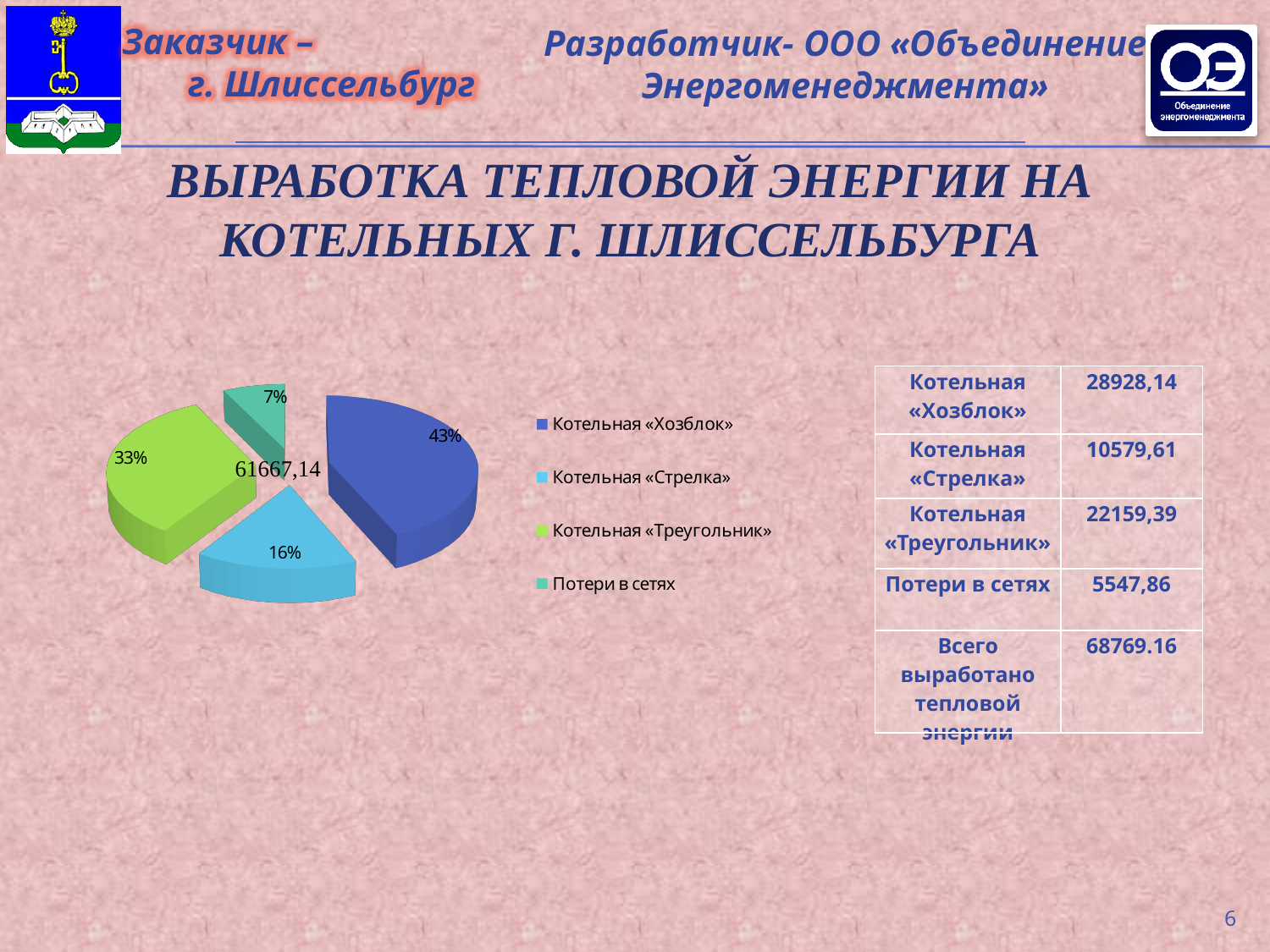
What is the difference in percentage points between the shares of Котельная «Хозблок» and Котельная «Треугольник»? 10% What share of the pie does Котельная «Хозблок» have? 43% How many slices does the pie chart have? 4 What share of the pie does Котельная «Треугольник» have? 33% Which slice of the pie chart is the smallest? Потери в сетях What share of the pie does Потери в сетях have? 7% How many entries does the legend of the pie chart list? 4 What kind of chart is shown on the slide? pie chart Which has a larger share of the pie, Котельная «Стрелка» or Котельная «Треугольник»? Котельная «Треугольник» What colour is the slice for Котельная «Стрелка» in the pie chart? light blue Which slice of the pie chart is the largest? Котельная «Хозблок»